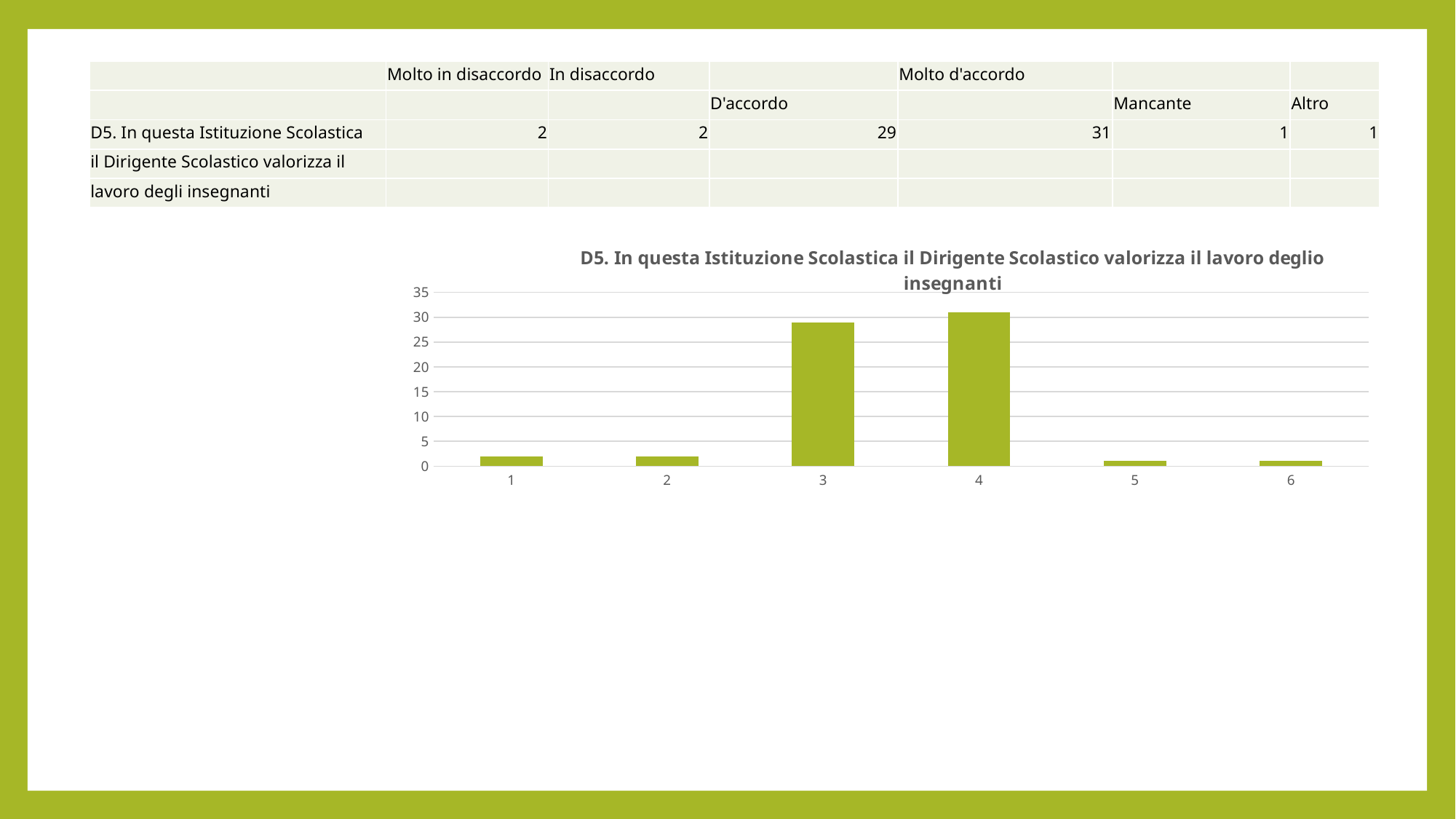
How many bars (categories) does the chart show? 6 According to the table on the slide, what is the value plotted for category 3 (D'accordo)? 29 Is the value for category 4 greater or less than 30? greater Is the value for category 3 greater or less than 25? greater What kind of chart is shown on the slide? bar chart Is the bar for category 3 taller or shorter than the bar for category 4? shorter Is the value for category 1 greater or less than 5? less Using the values in the table, what is the difference between the values for category 4 and category 3? 2 According to the table on the slide, what is the value plotted for category 4 (Molto d'accordo)? 31 Which category has the tallest bar in the chart? 4 What is the highest value shown on the chart's vertical axis? 35